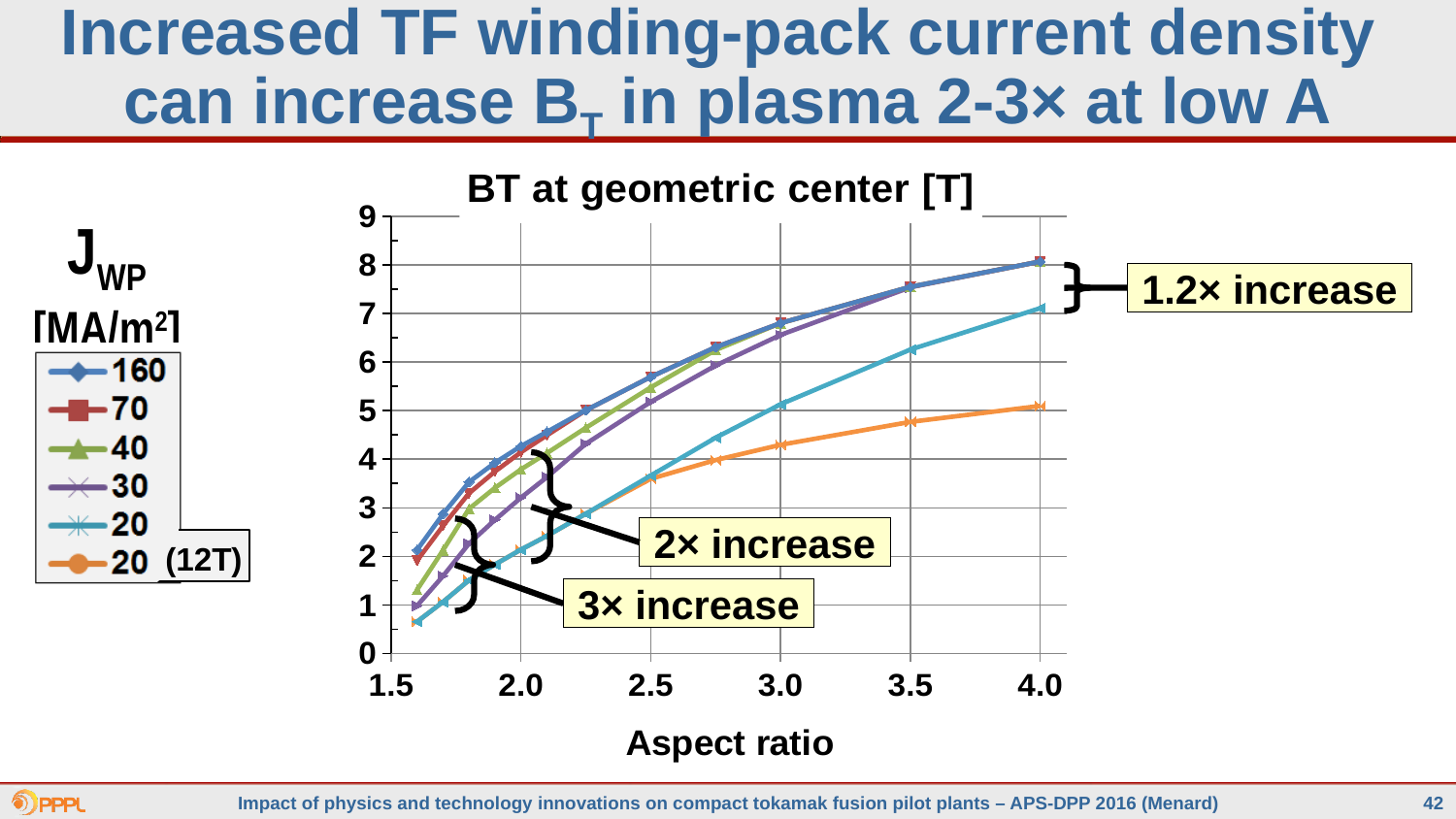
Is the value for the 160 series at aspect ratio 4.0 greater or less than 7? greater What type of chart is shown on the slide? line chart Is the value for the 20 series at aspect ratio 3.5 greater or less than 5? greater Which series has the lowest value at aspect ratio 4.0? 20 (12T) At aspect ratio 4.0, which series has the larger value, 160 or 20 (12T)? 160 What is the label of the x axis? Aspect ratio Is the value for the 20 series at the lowest aspect ratio plotted greater or less than 1? less Do the values of the 160 series rise or fall as aspect ratio increases? rise What is the title of the chart? BT at geometric center [T] How many series does the legend list? 6 At aspect ratio 2.0, which series has the larger value, 40 or 30? 40